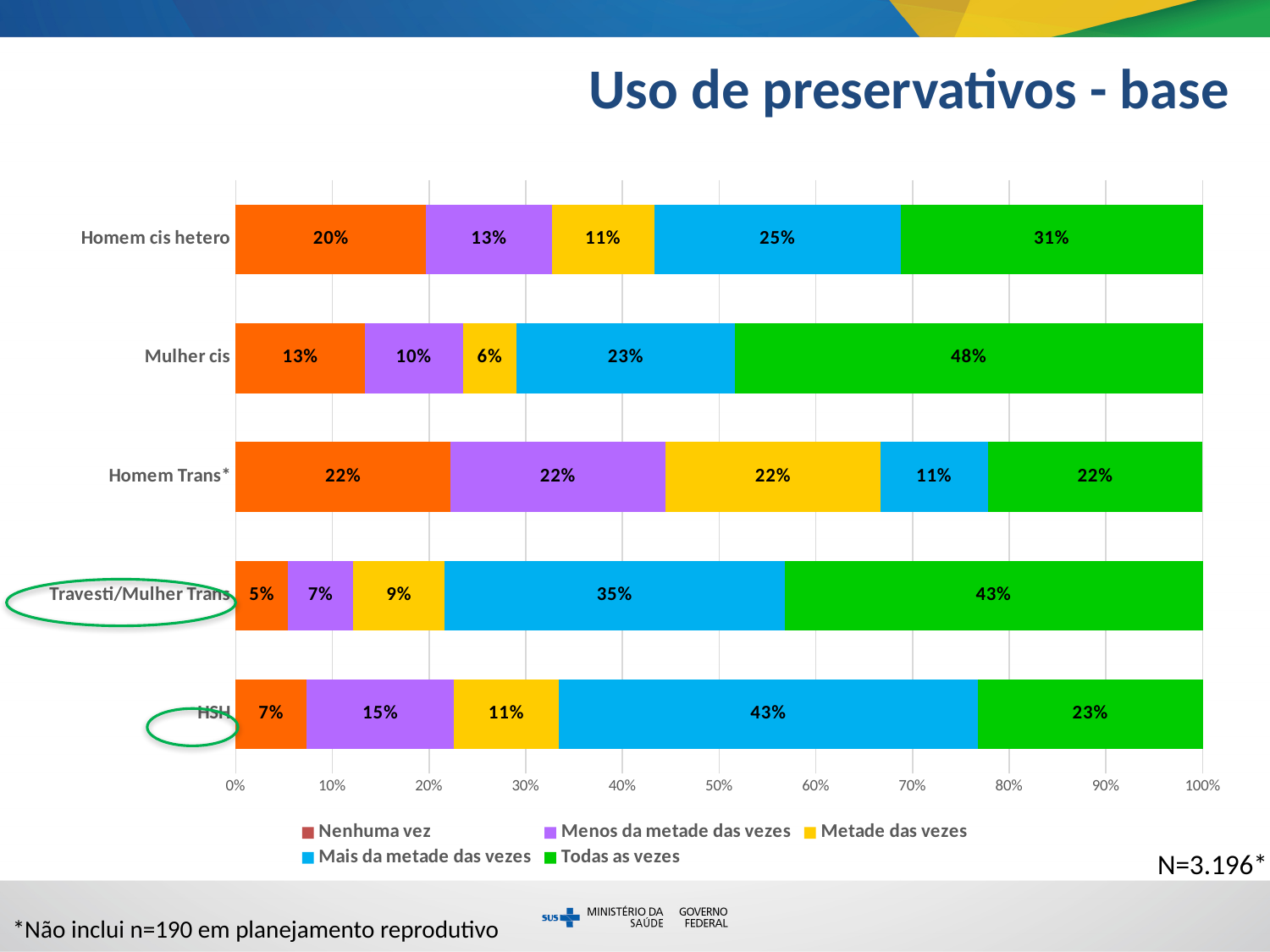
What is the title of the chart? Uso de preservativos - base How many categories (groups) are shown on the chart? 5 What is the value of "Metade das vezes" for Homem Trans*? 22% Which is larger: the "Mais da metade das vezes" value for HSH or for Travesti/Mulher Trans? HSH Which category has the highest value for "Todas as vezes"? Mulher cis What is the value of "Mais da metade das vezes" for HSH? 43% What is the value of "Nenhuma vez" for Travesti/Mulher Trans? 5% How many series does the legend list? 5 What kind of chart is shown on the slide? Stacked bar chart What is the difference between the "Todas as vezes" values for Mulher cis and Homem cis hetero? 17% Which category has the lowest value for "Nenhuma vez"? Travesti/Mulher Trans What is the value of "Todas as vezes" for Mulher cis? 48%